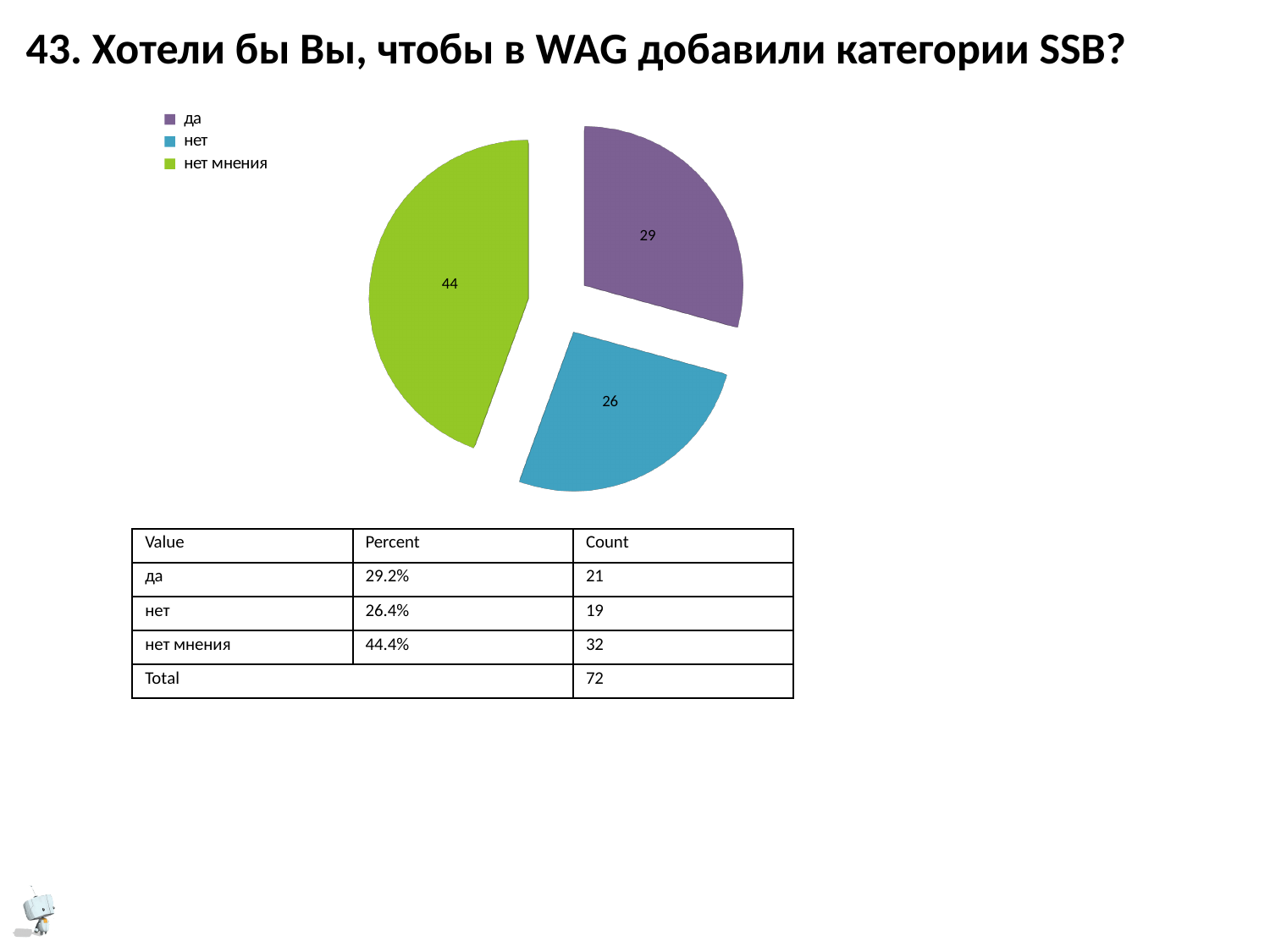
What kind of chart is shown on the slide? pie chart What value is labelled on the pie slice for "да"? 29 Which slice is larger, "да" or "нет"? да What value is labelled on the pie slice for "нет"? 26 What is the difference between the labelled values for "нет мнения" and "да"? 15 Which category has the largest slice of the pie? нет мнения Which category has the smallest slice of the pie? нет What colour is the slice for "нет мнения"? green What is the difference between the labelled values for "нет мнения" and "нет"? 18 How many entries does the legend list? 3 How many slices does the pie chart have? 3 What value is labelled on the pie slice for "нет мнения"? 44